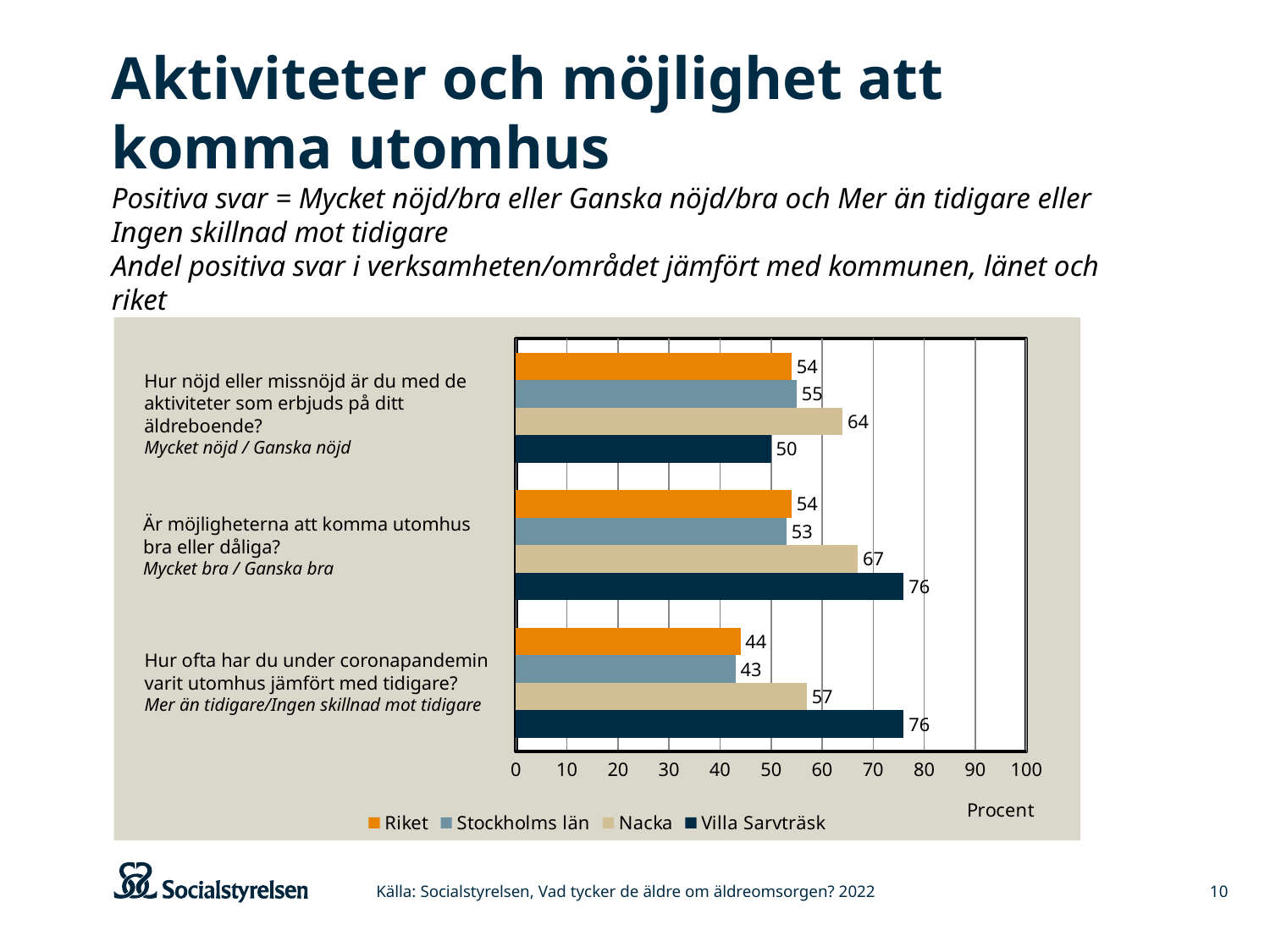
What is the value for Nacka on the question "Hur nöjd eller missnöjd är du med de aktiviteter som erbjuds på ditt äldreboende?"? 64 How many series does the legend list? 4 What is the value for Villa Sarvträsk on the question "Är möjligheterna att komma utomhus bra eller dåliga?"? 76 What unit label is shown below the x axis of the chart? Procent Which series has the highest value on the question "Hur nöjd eller missnöjd är du med de aktiviteter som erbjuds på ditt äldreboende?"? Nacka Which is larger on the question "Är möjligheterna att komma utomhus bra eller dåliga?": Nacka or Villa Sarvträsk? Villa Sarvträsk What is the difference between Villa Sarvträsk and Riket on the question "Hur ofta har du under coronapandemin varit utomhus jämfört med tidigare?"? 32 What kind of chart is shown on the slide? Bar chart Is the value for Villa Sarvträsk on the question "Hur nöjd eller missnöjd är du med de aktiviteter som erbjuds på ditt äldreboende?" greater or less than 60? less How many question categories are shown on the chart? 3 What is the value for Stockholms län on the question "Hur ofta har du under coronapandemin varit utomhus jämfört med tidigare?"? 43 Which series has the lowest value on the question "Hur ofta har du under coronapandemin varit utomhus jämfört med tidigare?"? Stockholms län